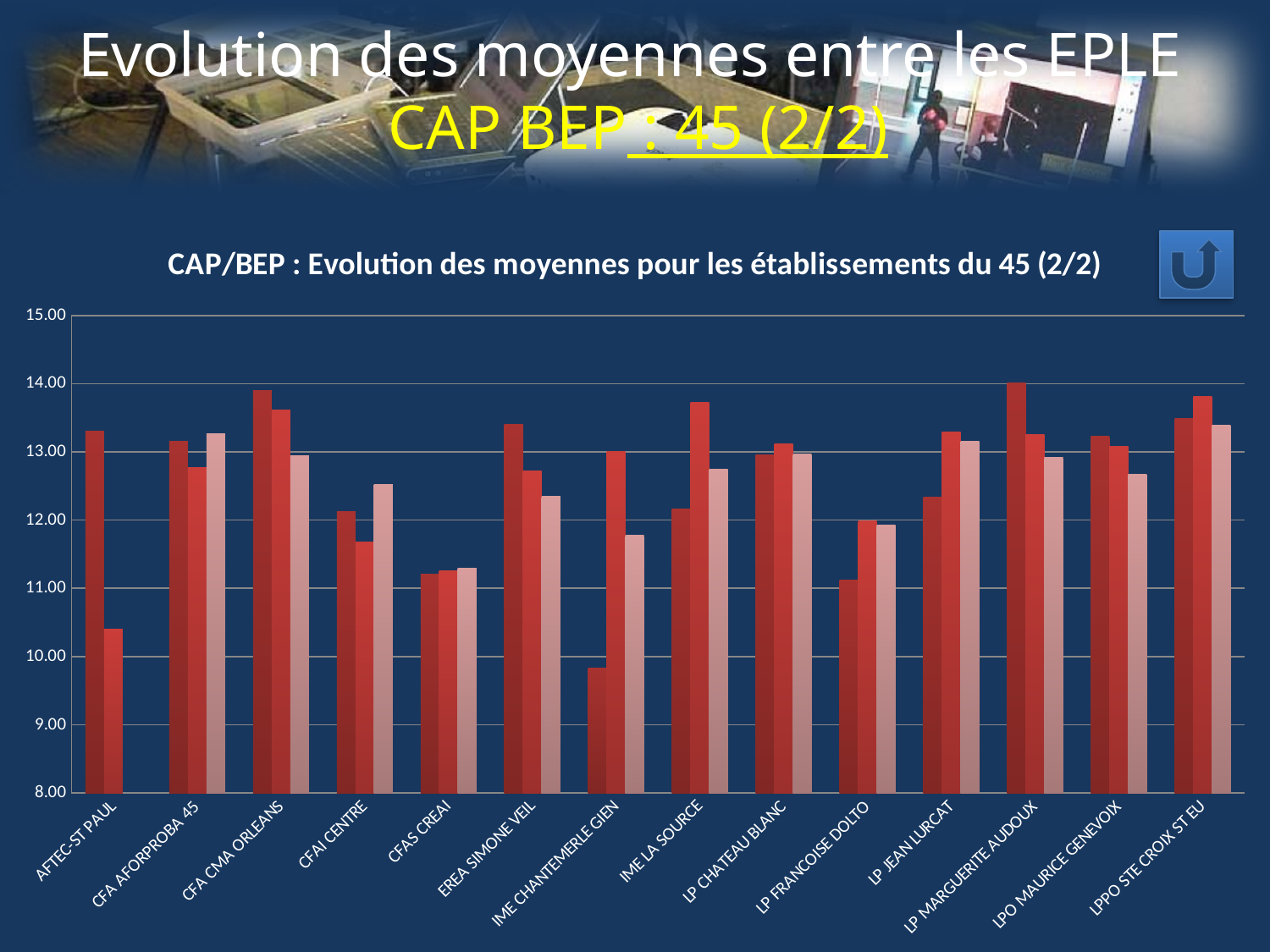
Are all the bars for CFAS CREAI greater or less than 12.00? less Is the first (leftmost) bar for CFA CMA ORLEANS greater or less than 13.00? greater Which is taller: the first bar for CFAS CREAI or the first bar for CFA CMA ORLEANS? CFA CMA ORLEANS How many bars are plotted for AFTEC-ST PAUL? 2 Is the first (leftmost) bar for LP MARGUERITE AUDOUX greater or less than 13.00? greater What are the lowest and highest values shown on the y axis? 8.00 and 15.00 What is the title of the chart? CAP/BEP : Evolution des moyennes pour les établissements du 45 (2/2) What kind of chart is shown on the slide? bar chart Which establishment has the lowest bar on the chart? IME CHANTEMERLE GIEN How many establishments (categories) are shown on the x axis of the chart? 14